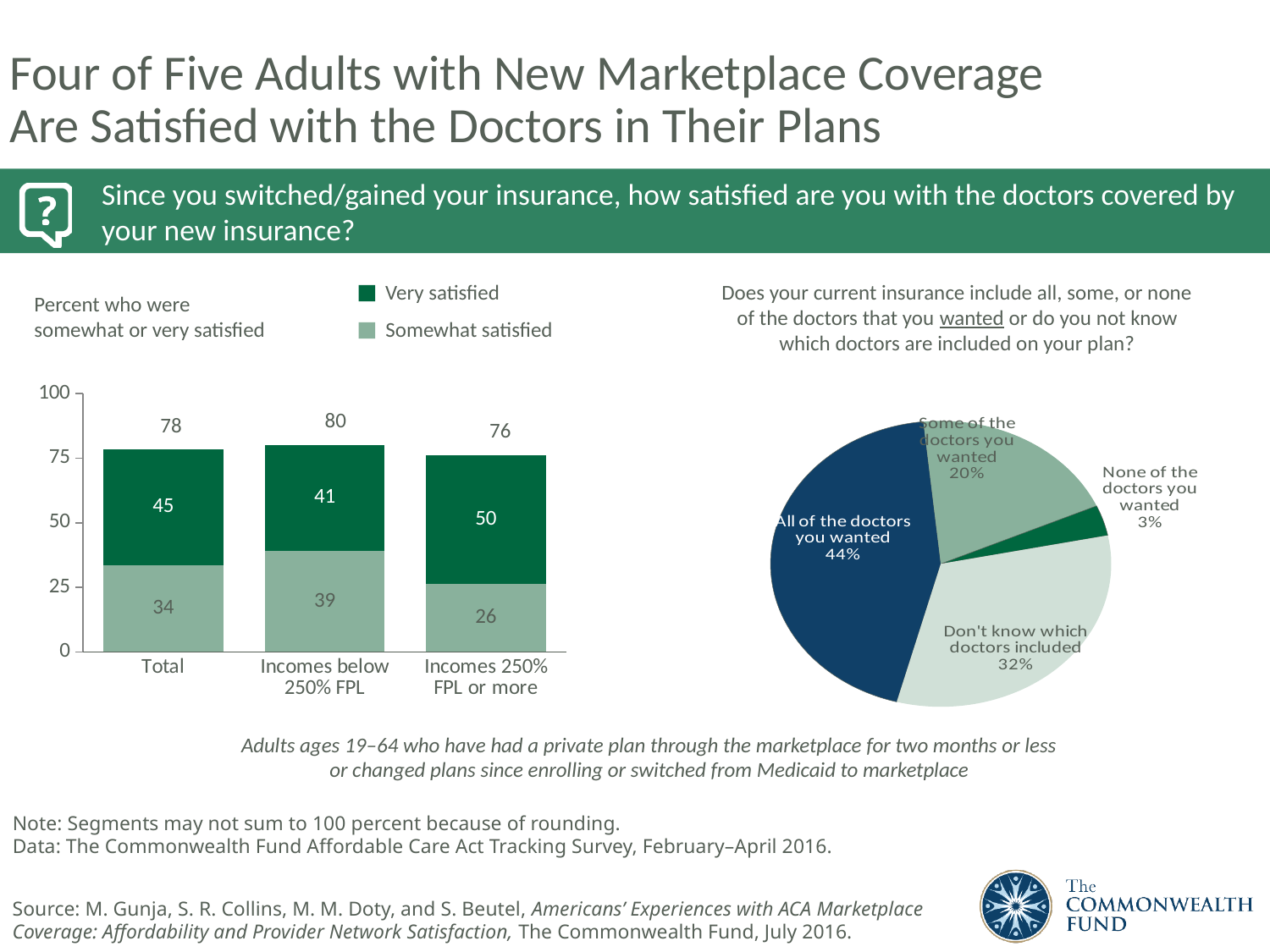
In the bar chart on the left, which category has the highest total percent somewhat or very satisfied? Incomes below 250% FPL In the bar chart on the left, what is the difference between the 'Very satisfied' values for Incomes 250% FPL or more and Incomes below 250% FPL? 9 In the pie chart on the right, what share of respondents said their insurance includes all of the doctors they wanted? 44% In the bar chart on the left, is the 'Somewhat satisfied' value larger for Total or for Incomes below 250% FPL? Incomes below 250% FPL In the bar chart on the left, how many series does the legend list? 2 In the pie chart on the right, which response has the smallest share? None of the doctors you wanted In the bar chart on the left, what is the total of the stacked bar for Incomes below 250% FPL? 80 In the bar chart on the left, what is the 'Somewhat satisfied' value for Total? 34 In the bar chart on the left, what is the 'Very satisfied' value for Incomes 250% FPL or more? 50 What kind of chart is on the right side of the slide? Pie chart In the bar chart on the left, which category has the lowest 'Somewhat satisfied' value? Incomes 250% FPL or more In the bar chart on the left, how many categories are shown on the x axis? 3